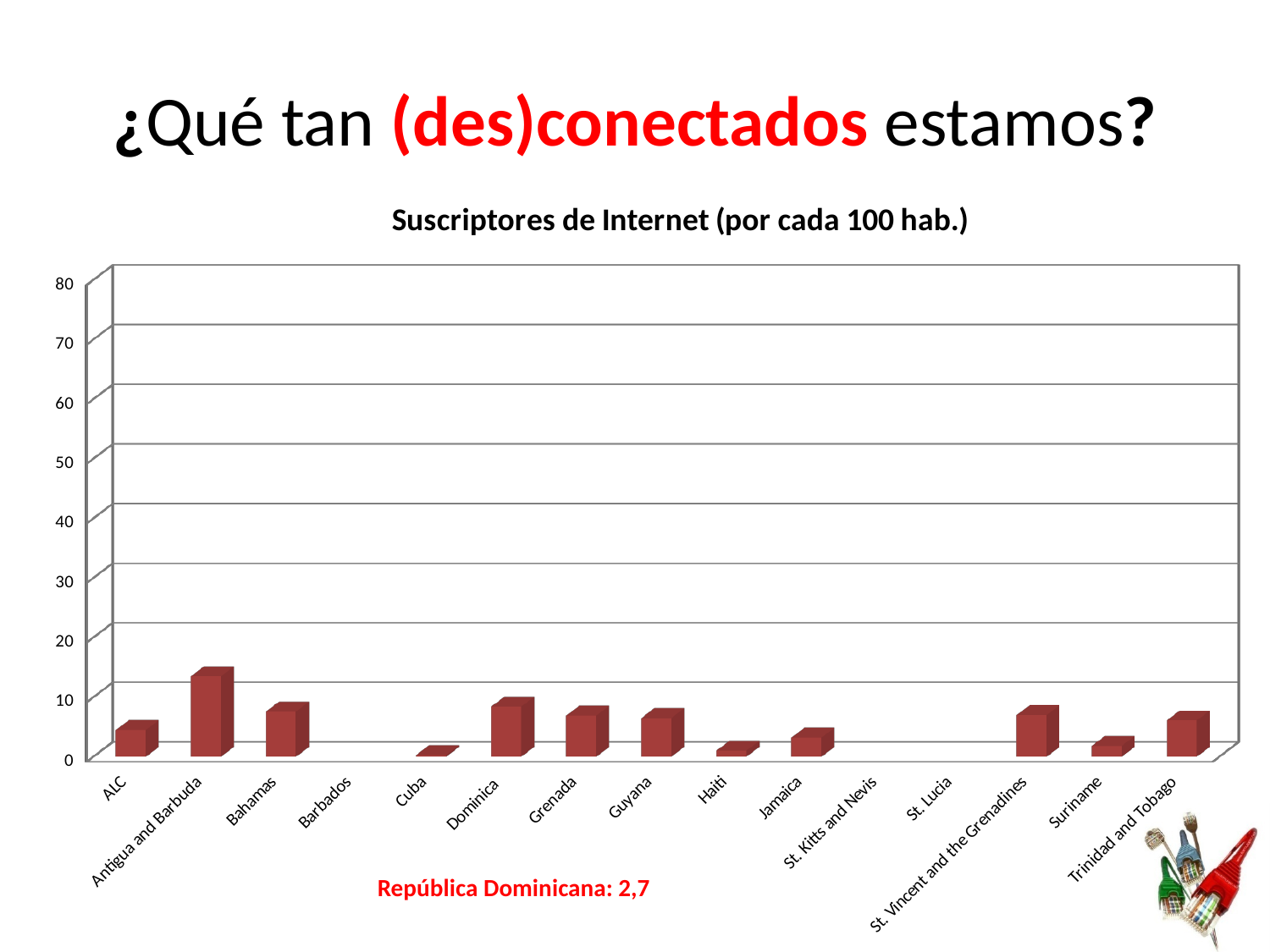
Which is larger, the value for Jamaica or the value for Cuba? Jamaica Is the value for Dominica greater or less than 20? less Which is larger, the value for Antigua and Barbuda or the value for Bahamas? Antigua and Barbuda What kind of chart is shown on the slide? bar chart Which is larger, the value for Dominica or the value for Haiti? Dominica What value does the slide give for República Dominicana in the text below the chart? 2,7 Which category has the highest bar in the chart? Antigua and Barbuda What is the title of the chart? Suscriptores de Internet (por cada 100 hab.) Is the value for Antigua and Barbuda greater or less than 10? greater Is the value for Bahamas greater or less than 10? less How many categories are shown on the x axis of the chart? 15